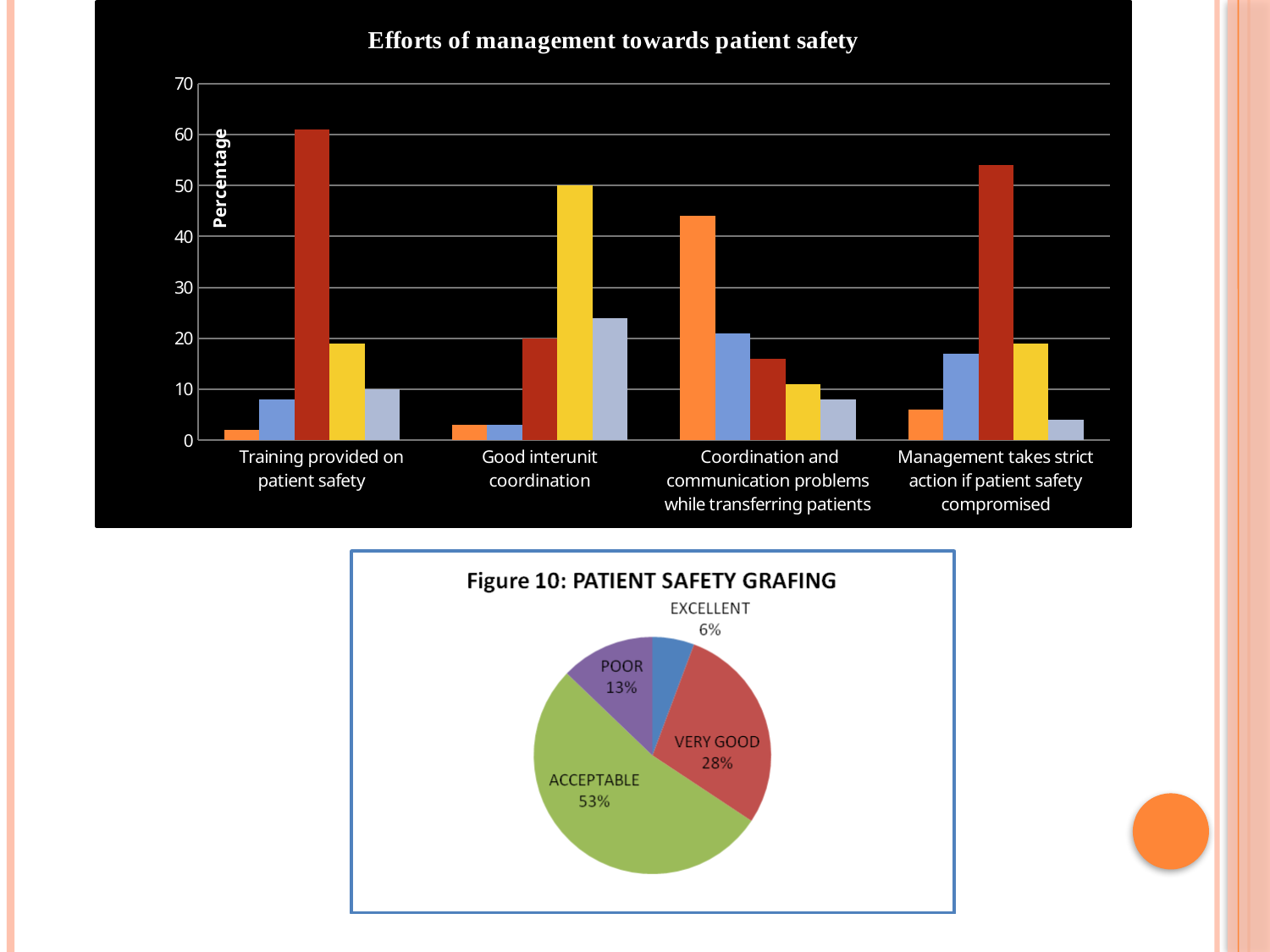
In the bar chart 'Efforts of management towards patient safety', is the value of the red bar for 'Training provided on patient safety' greater or less than 50? greater In the pie chart 'Figure 10: PATIENT SAFETY GRAFING', which category has the smallest share? EXCELLENT How many categories are shown on the x axis of the bar chart 'Efforts of management towards patient safety'? 4 In the pie chart 'Figure 10: PATIENT SAFETY GRAFING', what percentage is labelled ACCEPTABLE? 53% In the pie chart 'Figure 10: PATIENT SAFETY GRAFING', which is larger, POOR or EXCELLENT? POOR What is the label on the vertical axis of the bar chart 'Efforts of management towards patient safety'? Percentage In the pie chart 'Figure 10: PATIENT SAFETY GRAFING', what percentage is labelled VERY GOOD? 28% What kind of chart is the top chart titled 'Efforts of management towards patient safety'? bar chart How many slices does the pie chart 'Figure 10: PATIENT SAFETY GRAFING' have? 4 In the pie chart 'Figure 10: PATIENT SAFETY GRAFING', which category has the largest share? ACCEPTABLE In the bar chart 'Efforts of management towards patient safety', is the value of the orange bar for 'Coordination and communication problems while transferring patients' greater or less than 40? greater In the pie chart 'Figure 10: PATIENT SAFETY GRAFING', what is the difference in percentage points between ACCEPTABLE and VERY GOOD? 25